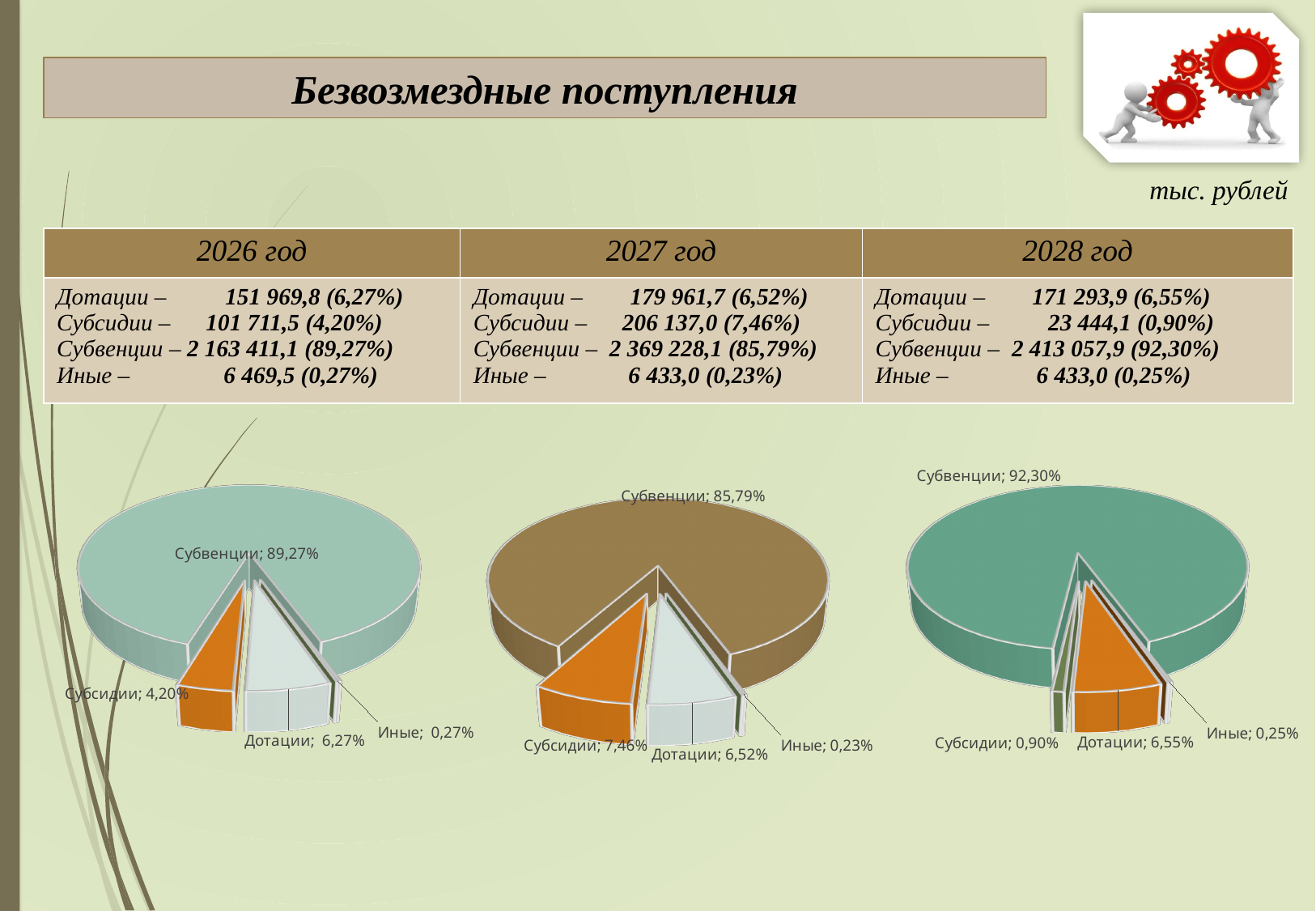
In the right pie chart (2028), what share is labelled for Иные? 0,25% In the right pie chart (2028), which is larger: the Дотации slice or the Субсидии slice? Дотации In the middle pie chart (2027), which category has the largest slice? Субвенции In the middle pie chart (2027), which is larger: the Субсидии slice or the Дотации slice? Субсидии In the left pie chart (2026), what share is labelled for Субвенции? 89,27% How many slices does each pie chart on the slide have? 4 What kind of chart is used on the slide to show the structure of gratuitous receipts? Pie chart In the left pie chart (2026), which category has the smallest slice? Иные In the middle pie chart (2027), what share is labelled for Субсидии? 7,46% How many pie charts are shown on the slide? 3 In the right pie chart (2028), what share is labelled for Дотации? 6,55% What is the difference between the Субвенции share in the right pie chart (2028) and in the left pie chart (2026)? 3,03%